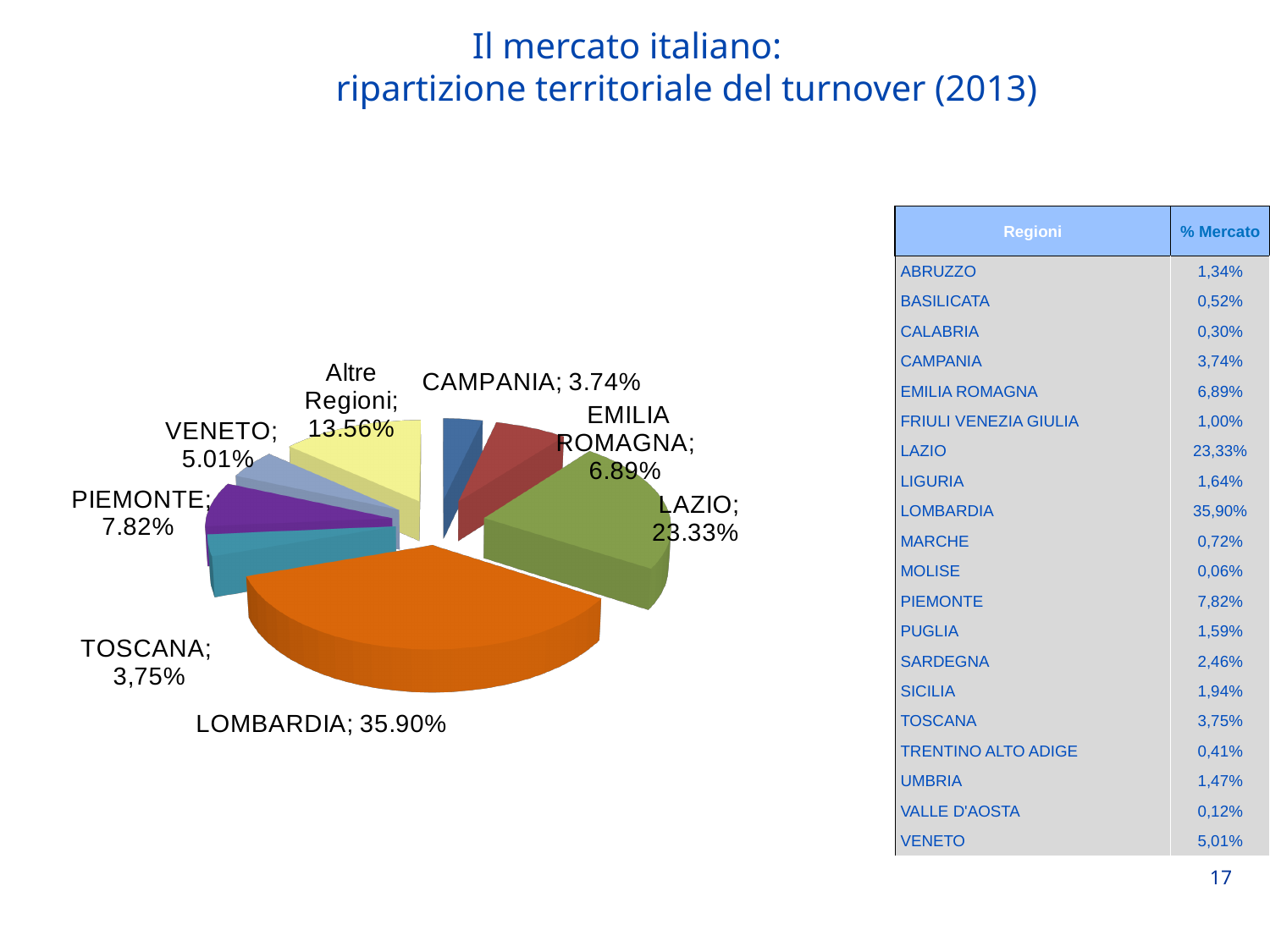
What kind of chart is shown on the slide? Pie chart What share of the pie does LOMBARDIA hold? 35.90% How many slices does the pie chart have? 8 What is the value shown for PIEMONTE in the pie chart? 7.82% Which region has the largest slice of the pie chart? LOMBARDIA What is the value shown for LAZIO in the pie chart? 23.33% What is the value shown for Altre Regioni in the pie chart? 13.56% What is the value shown for EMILIA ROMAGNA in the pie chart? 6.89% What is the title of the slide containing the pie chart? Il mercato italiano: ripartizione territoriale del turnover (2013) What is the difference between the PIEMONTE and VENETO slices? 2.81% Which slice is larger, LAZIO or Altre Regioni? LAZIO What is the difference between the LOMBARDIA and LAZIO slices? 12.57%